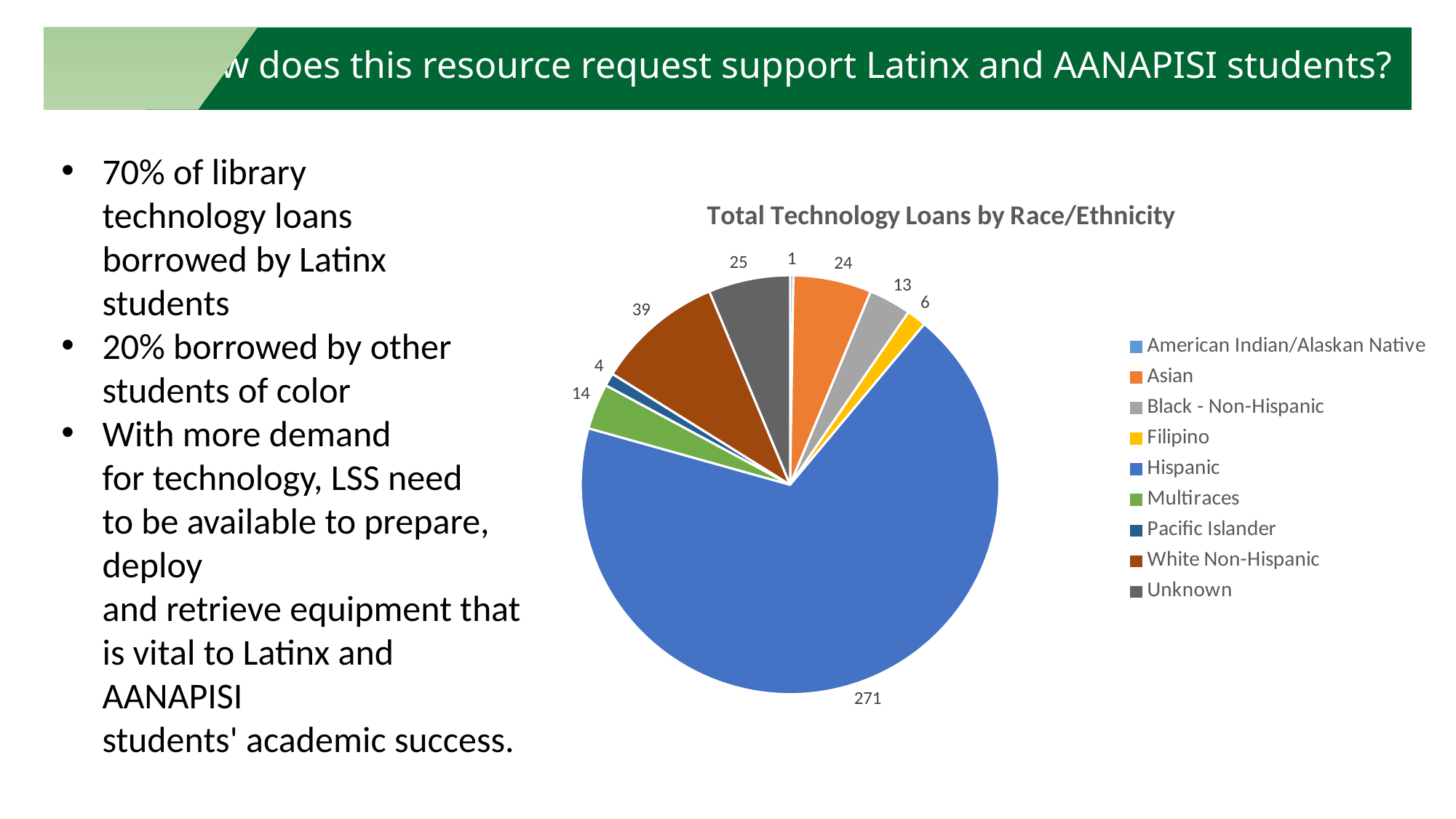
What colour is the Filipino slice in the pie chart? yellow What is the value for the Unknown category? 25 Which category has the largest slice of the pie chart? Hispanic What is the difference between the Hispanic value and the White Non-Hispanic value? 232 How many categories does the legend of the pie chart list? 9 What is the value for Asian in the pie chart? 24 What type of chart is shown on the slide? pie chart How many technology loans were borrowed by Hispanic students? 271 What is the title of the chart? Total Technology Loans by Race/Ethnicity Which is larger, the value for Multiraces or the value for Black - Non-Hispanic? Multiraces Which category has the smallest slice of the pie chart? American Indian/Alaskan Native What is the value for White Non-Hispanic in the pie chart? 39